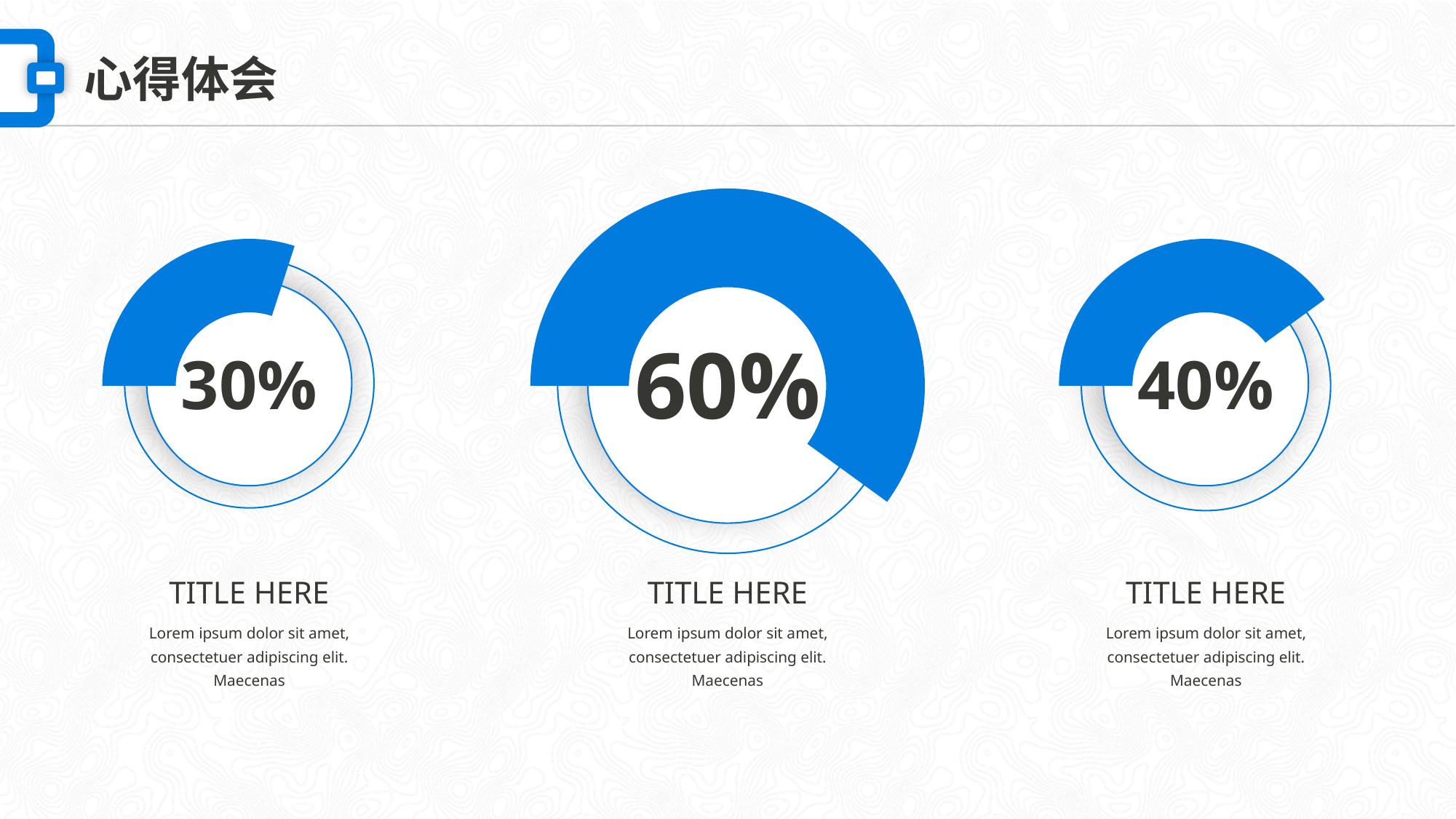
Which is larger, the value in the right chart or the value in the left chart? right chart What value is shown in the right chart? 40% What value is shown in the middle chart? 60% What colour is the filled portion of each ring chart? blue Is the value in the middle chart greater or less than 50%? greater What value is shown in the left chart? 30% What kind of chart is used to display the percentages on the slide? donut chart How many percentage charts are shown on the slide? 3 Which of the three charts shows the lowest percentage: left, middle or right? left What is the difference between the value in the right chart and the value in the left chart? 10% Which of the three charts shows the highest percentage: left, middle or right? middle What is the difference between the value in the middle chart and the value in the left chart? 30%